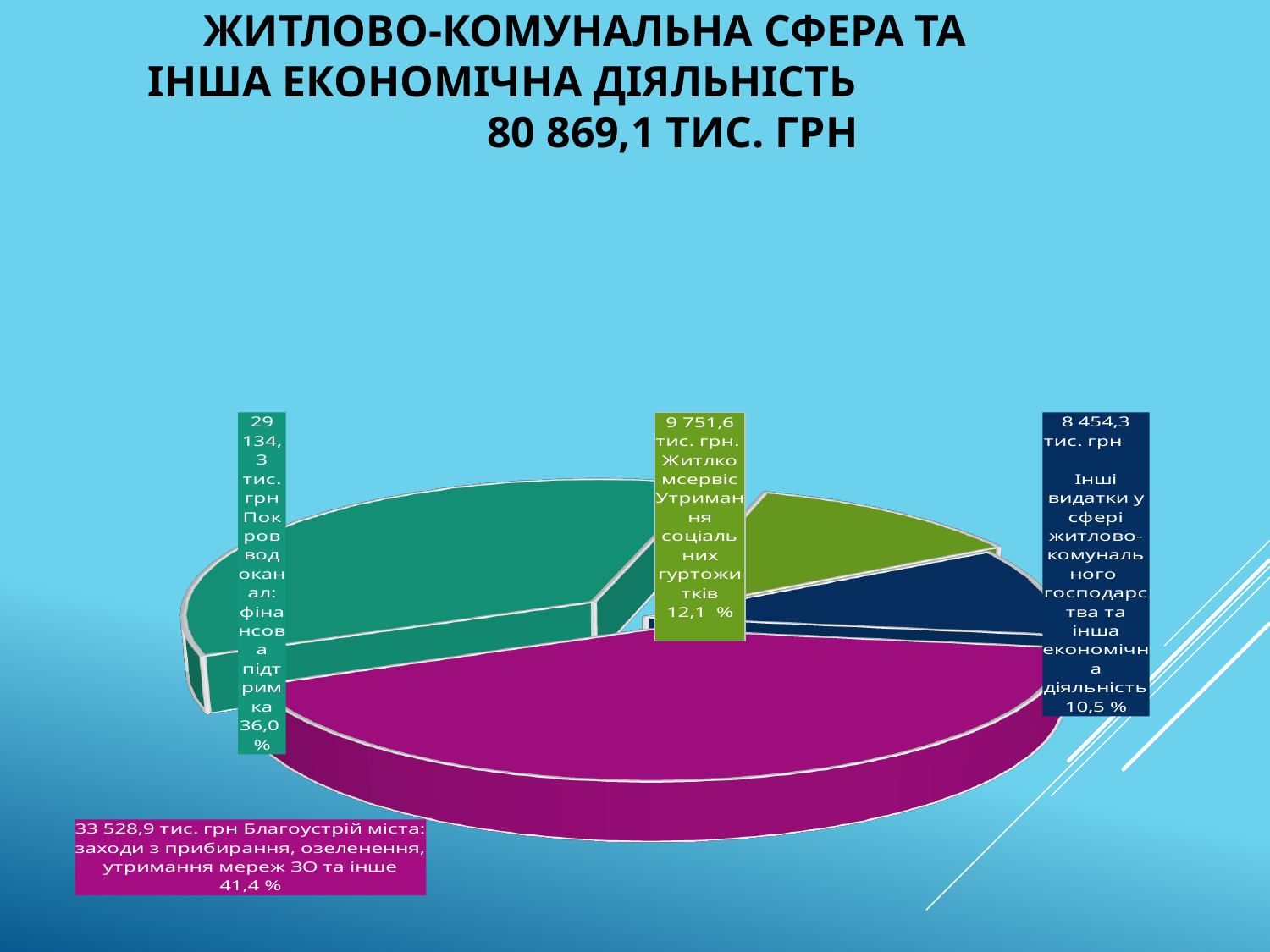
What share of the pie does Покровводоканал: фінансова підтримка take? 36,0 % What is the value for Житлкомсервіс Утримання соціальних гуртожитків? 9 751,6 тис. грн What kind of chart is shown on the slide? pie chart Which is larger: Житлкомсервіс Утримання соціальних гуртожитків or Покровводоканал: фінансова підтримка? Покровводоканал: фінансова підтримка What share of the pie do Інші видатки у сфері житлово-комунального господарства та інша економічна діяльність take? 10,5 % Which category has the smallest slice? Інші видатки у сфері житлово-комунального господарства та інша економічна діяльність What is the value for Покровводоканал: фінансова підтримка? 29 134,3 тис. грн What is the value for Благоустрій міста? 33 528,9 тис. грн Which category has the largest slice? Благоустрій міста What total amount is stated in the chart title? 80 869,1 тис. грн How many slices does the pie chart have? 4 What share of the pie does Благоустрій міста take? 41,4 %